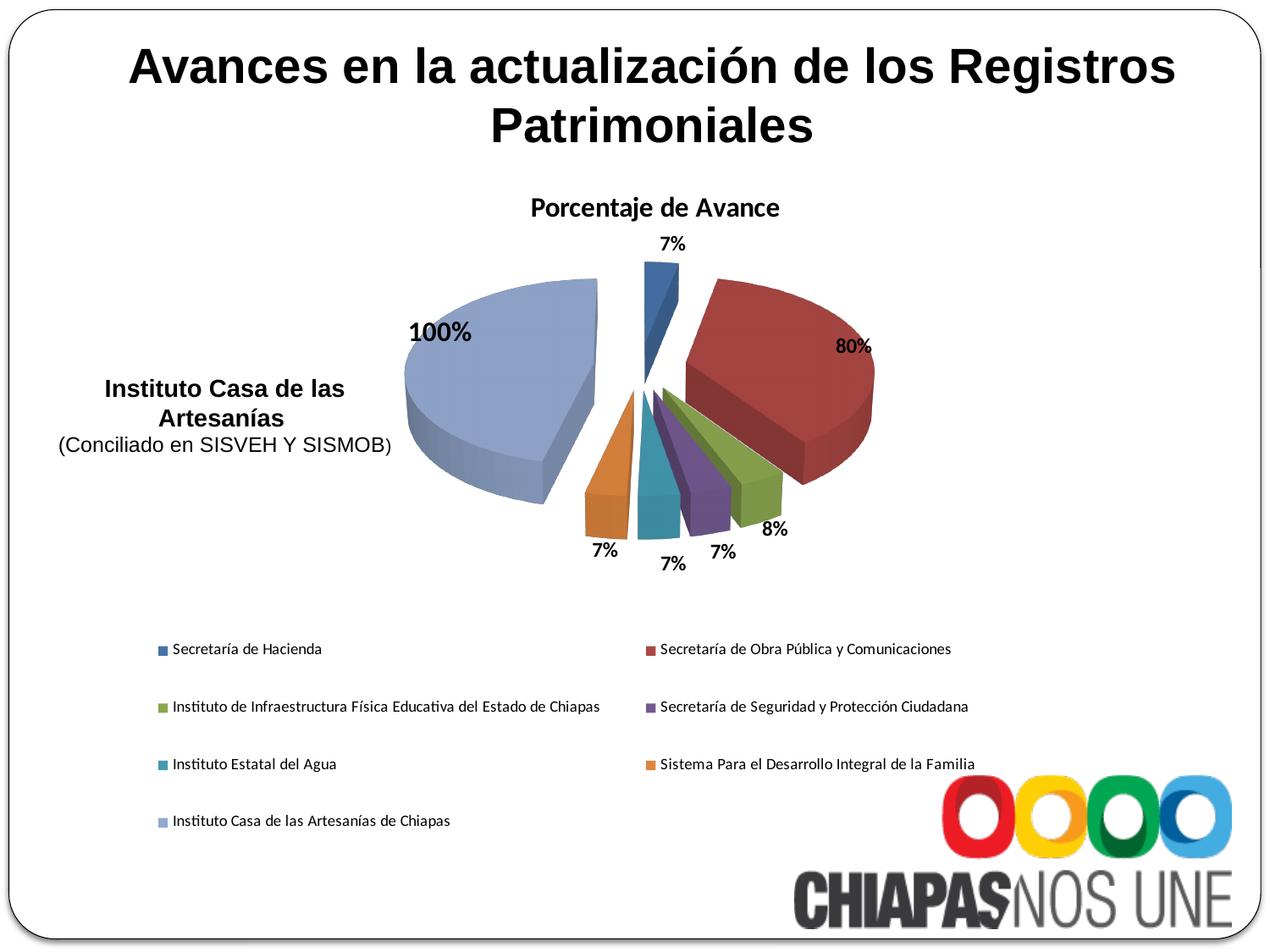
What is the value shown for Instituto Estatal del Agua? 7% Which is larger: the value for Secretaría de Obra Pública y Comunicaciones or the value for Instituto de Infraestructura Física Educativa del Estado de Chiapas? Secretaría de Obra Pública y Comunicaciones What is the value shown for Instituto Casa de las Artesanías de Chiapas? 100% What colour is the slice for Sistema Para el Desarrollo Integral de la Familia? Orange What kind of chart is shown on the slide? Pie chart How many categories does the pie chart have? 7 What is the value shown for Secretaría de Obra Pública y Comunicaciones? 80% What is the title of the chart? Porcentaje de Avance What is the difference between the value for Instituto Casa de las Artesanías de Chiapas and the value for Secretaría de Obra Pública y Comunicaciones? 20% What is the value shown for Secretaría de Hacienda? 7% What is the value shown for Instituto de Infraestructura Física Educativa del Estado de Chiapas? 8% Which category has the highest value in the chart? Instituto Casa de las Artesanías de Chiapas